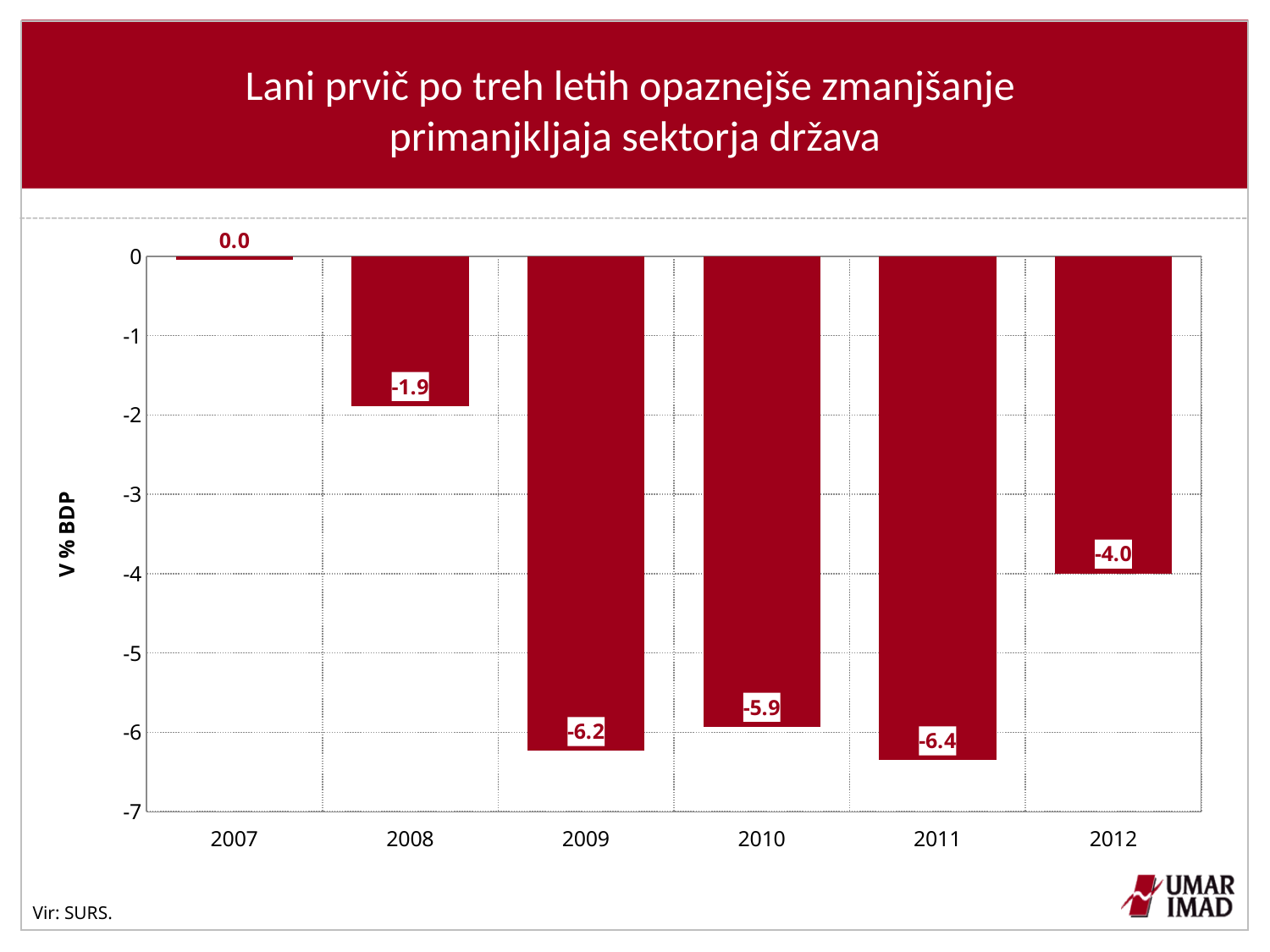
Which year has the lowest value? 2011 Is the value for 2010 greater or less than -5? less What is the value for 2009? -6.2 What is the value for 2012? -4.0 What is the value for 2007? 0.0 Do the values rise or fall from 2011 to 2012? rise What is the difference between the values for 2011 and 2012? 2.4 What is the label of the vertical axis? V % BDP How many years are shown on the x axis? 6 Which is larger, the value for 2008 or the value for 2010? 2008 What kind of chart is shown on the slide? bar chart Which year has the highest value? 2007